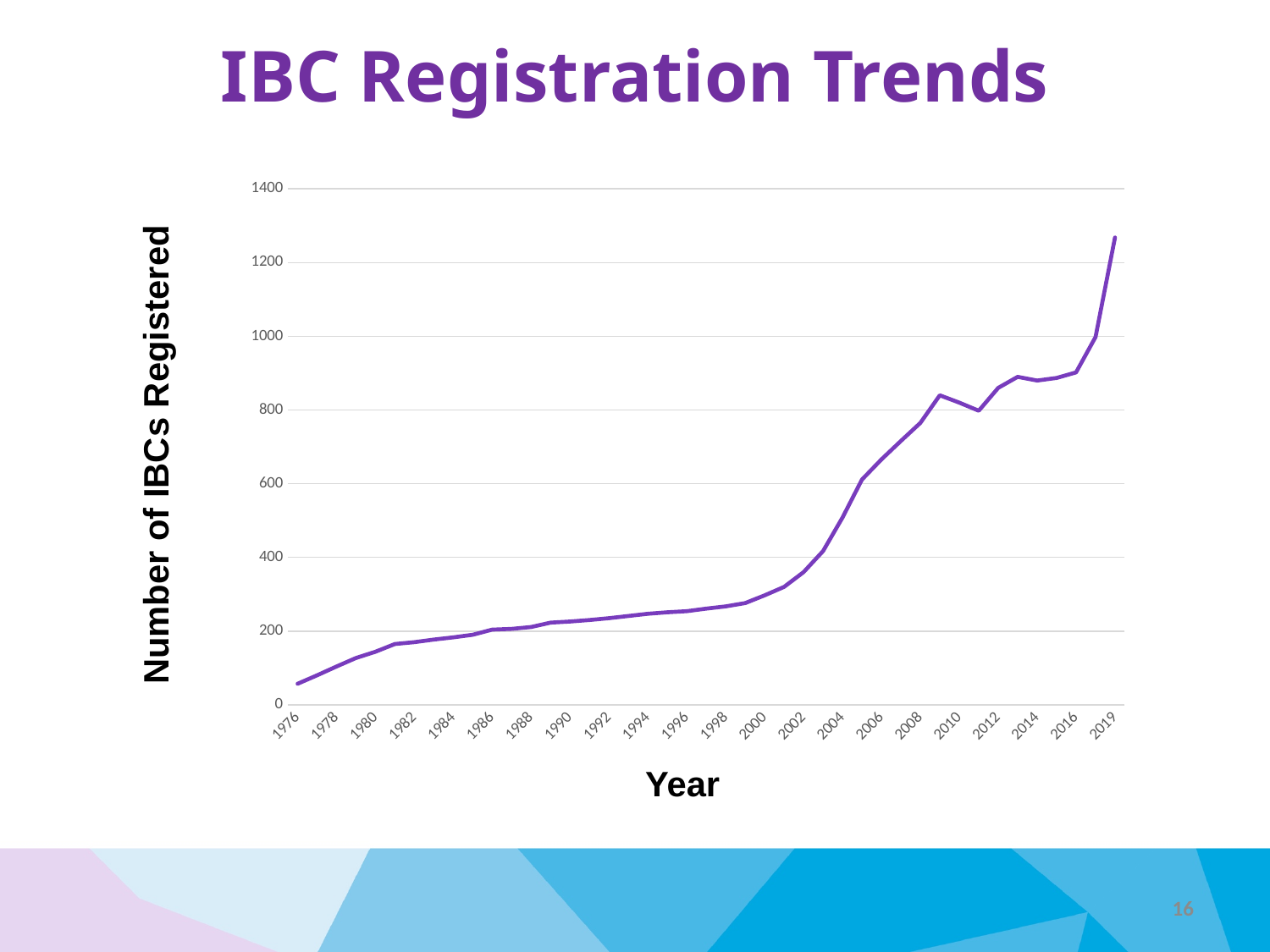
What kind of chart is shown on the slide? line chart Which year has a larger value, 1976 or 2000? 2000 Overall, do the values rise or fall from 1976 to 2019? rise Is the value for 2014 greater or less than 1000? less What is the title of the chart? IBC Registration Trends Which year has a larger value, 2010 or 2019? 2019 Which year has the lowest number of IBCs registered? 1976 Is the value for 2000 greater or less than 400? less What is the label on the vertical axis of the chart? Number of IBCs Registered Is the value for 1976 greater or less than 200? less Which year has the highest number of IBCs registered? 2019